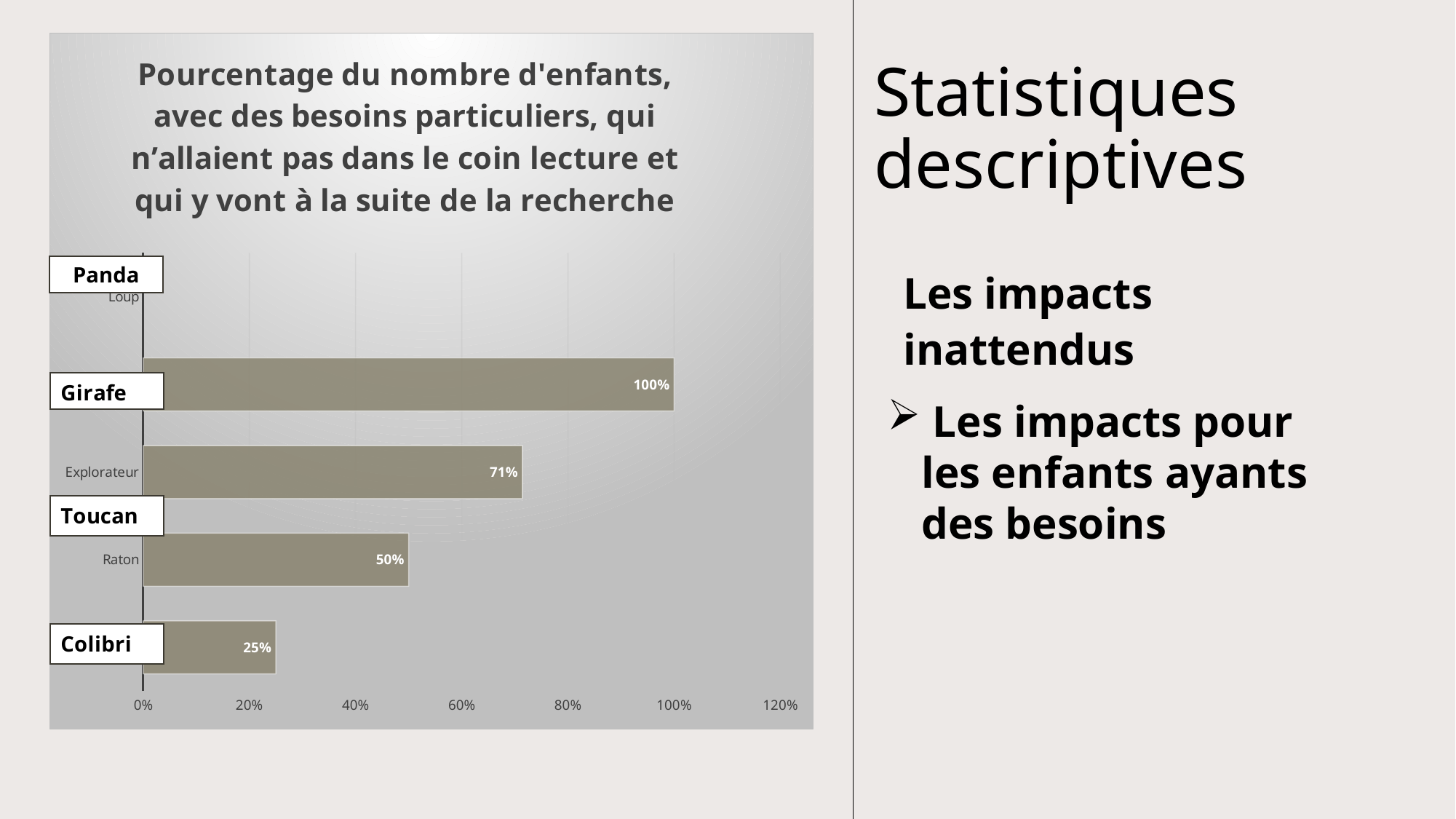
What type of chart is shown on the slide? bar chart Which is larger, the value for Explorateur or the value for Raton? Explorateur What is the difference between the values for Girafe and Explorateur? 29% What is the value for Explorateur? 71% How many bars are plotted in the chart? 4 What is the value for Girafe? 100% What is the value for Raton? 50% What is the value for Colibri? 25% Is the value for Explorateur greater or less than 60%? greater Which category with a plotted bar has the lowest value? Colibri What is the difference between the values for Raton and Colibri? 25% Which category has the highest value? Girafe